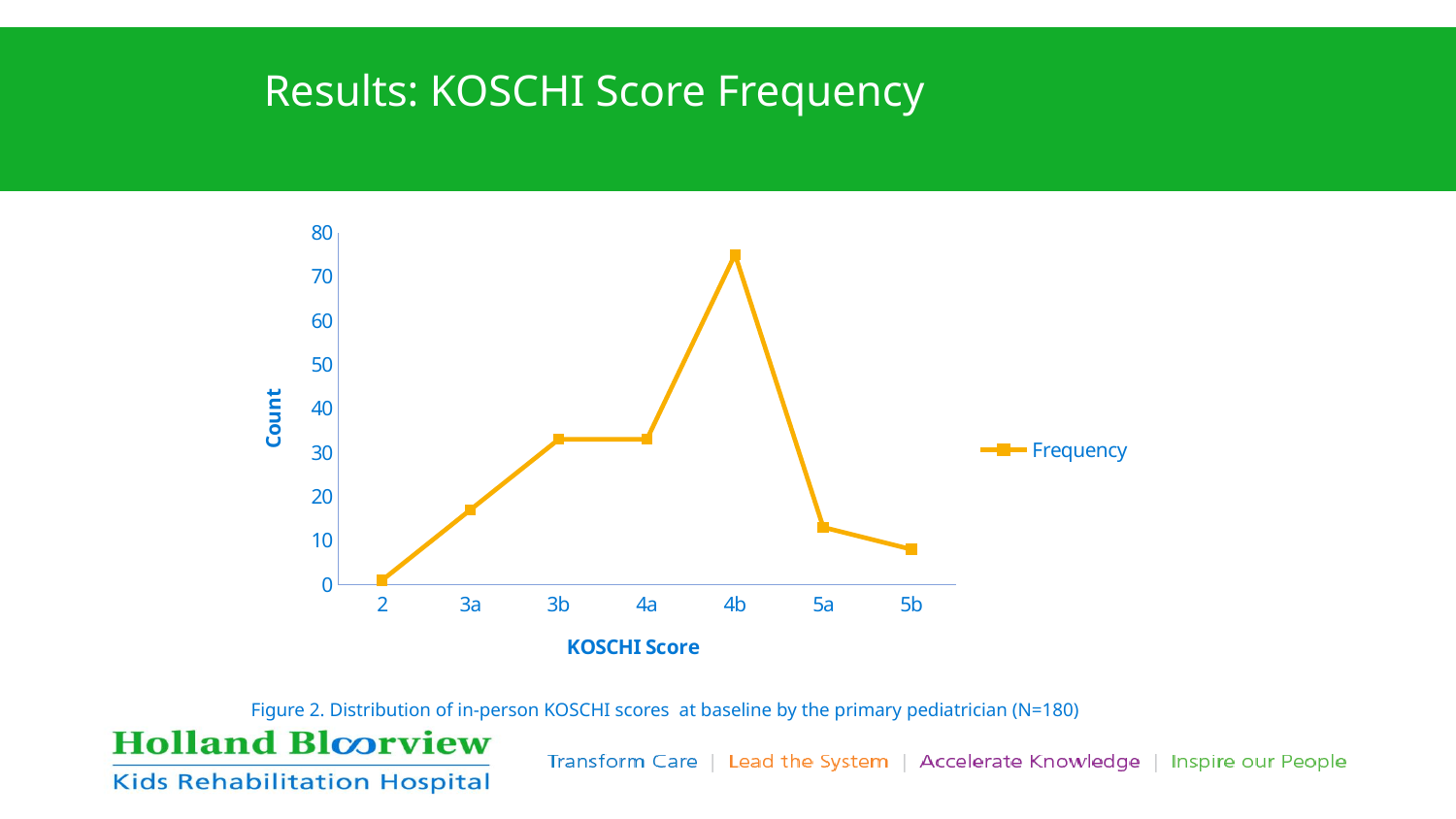
Is the count for KOSCHI score 4b greater or less than 70? greater Which KOSCHI score has the highest count? 4b Which has a higher count, KOSCHI score 3a or 5b? 3a How many KOSCHI score categories are plotted on the x axis? 7 Which KOSCHI score has the lowest count? 2 Is the count for KOSCHI score 5b greater or less than 10? less Is the count for KOSCHI score 3a greater or less than 20? less Do the counts rise or fall from KOSCHI score 4b to 5b? fall How many series does the legend list? 1 What is the label of the y axis? Count What kind of chart is shown on the slide? line chart